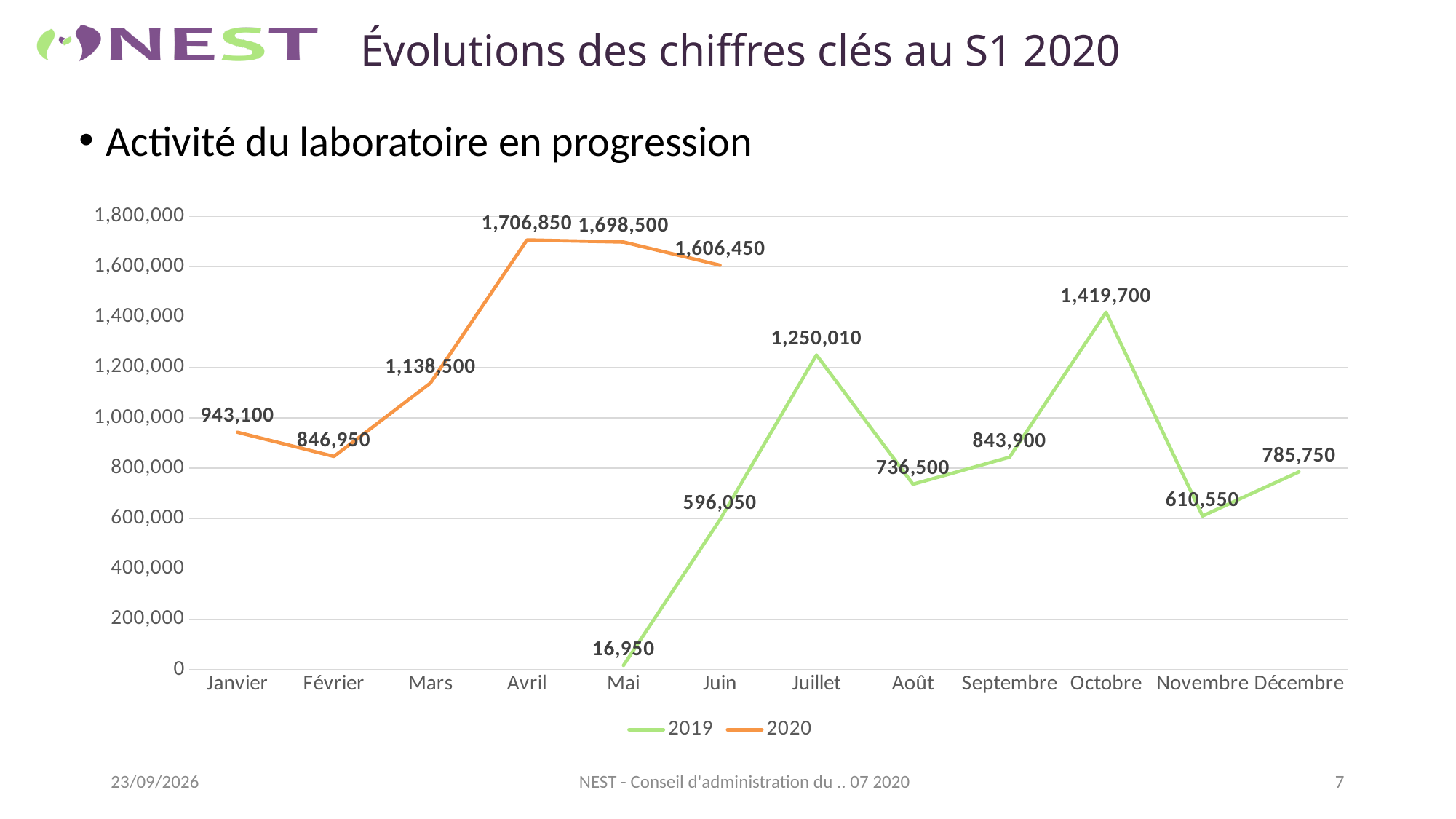
Which is larger: the 2019 value for Juillet or the 2019 value for Octobre? Octobre Which month has the lowest value in the 2019 series? Mai How many series does the legend list? 2 What is the difference between the 2020 value for Juin and the 2019 value for Juin? 1,010,400 What type of chart is shown on the slide? line chart Which month has the highest value in the 2020 series? Avril What is the value for Octobre in the 2019 series? 1,419,700 What is the value for Avril in the 2020 series? 1,706,850 Is the 2020 value for Mars greater or less than 1,000,000? greater What is the value for Mai in the 2019 series? 16,950 How many months are shown on the x axis? 12 Which colour is used for the 2020 series? orange